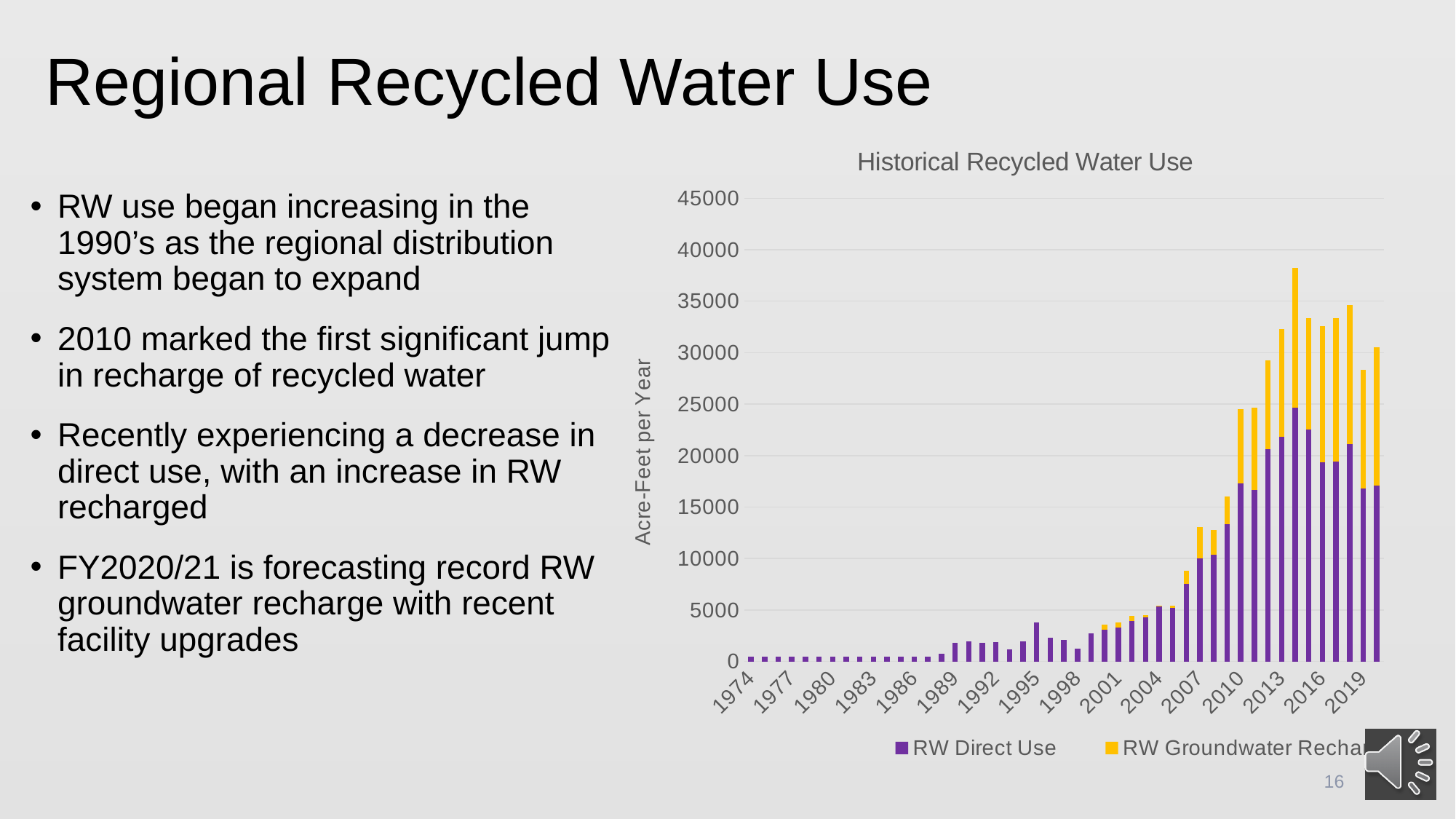
Is the total recycled water use for 1974 greater or less than 5000 acre-feet per year? less What kind of chart is shown on the slide? Stacked bar chart What is the title of the chart? Historical Recycled Water Use Does total recycled water use generally rise or fall from 1974 to 2013? rise Is the total recycled water use for 2010 greater or less than 20000 acre-feet per year? greater Which series is shown in purple on the chart? RW Direct Use In 2019, which series is larger, RW Direct Use or RW Groundwater Recharge? RW Direct Use Is the total recycled water use for 2019 greater or less than 25000 acre-feet per year? greater What is the label on the vertical axis of the chart? Acre-Feet per Year How many series does the chart legend list? 2